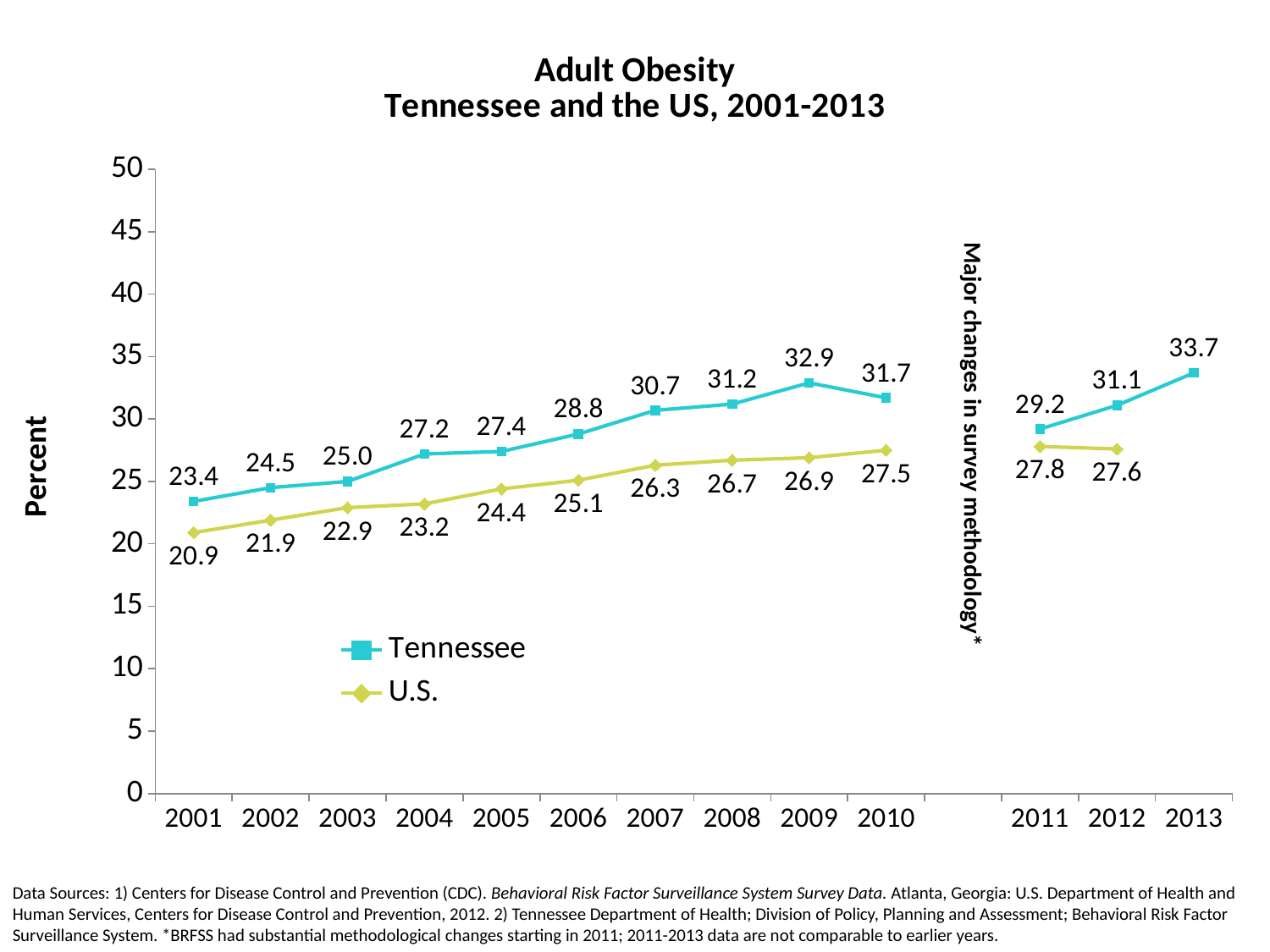
What is the U.S. value for 2001? 20.9 In which year does the Tennessee series reach its highest value? 2013 Is the Tennessee value for 2013 greater or less than 30? greater What is the difference between the Tennessee and U.S. values in 2010? 4.2 In 2011, which is larger, the Tennessee value or the U.S. value? Tennessee By how much did the Tennessee value change from 2011 to 2013? 4.5 How many years are shown on the x axis? 13 Does the U.S. series rise or fall from 2001 to 2010? rise What kind of chart is shown on the slide? line chart In which year is the U.S. value lowest? 2001 How many series does the legend list? 2 What is the Tennessee adult obesity value for 2009? 32.9